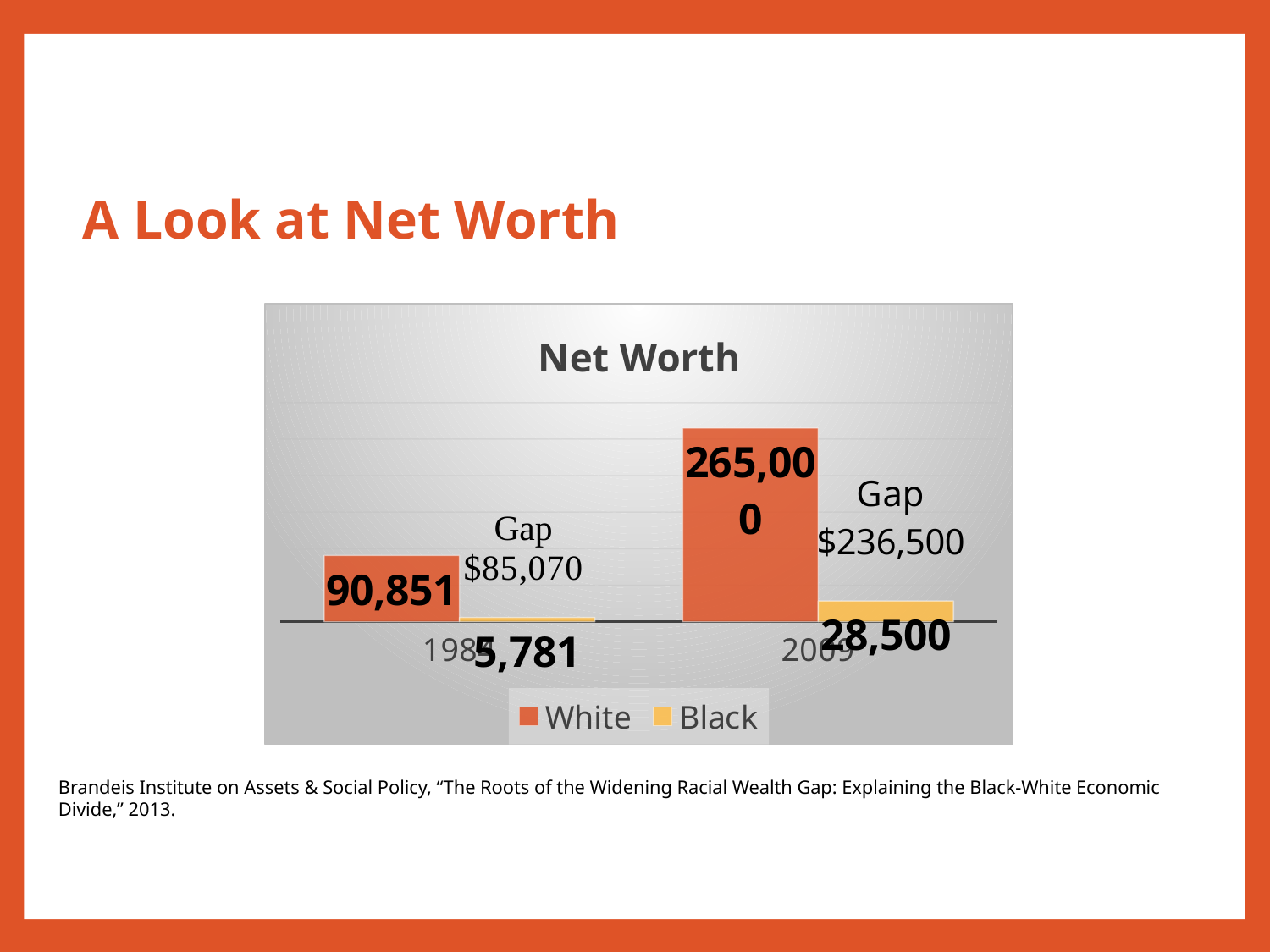
What is the difference between the White and Black values in the right group of the chart? 236,500 What is the title of the chart? Net Worth What is the value of the White bar in the left group of the chart? 90,851 Which bar in the chart has the highest value? White in the right group (265,000) Which bar in the chart has the lowest value? Black in the left group (5,781) What is the value of the Black bar in the left group of the chart? 5,781 What is the value of the Black bar in the right group of the chart? 28,500 How many series does the chart legend list? 2 What type of chart is shown on the slide? bar chart Does the White series rise or fall from the left group to the right group? rise Which series are listed in the chart legend? White, Black What is the value of the White bar in the right group of the chart? 265,000